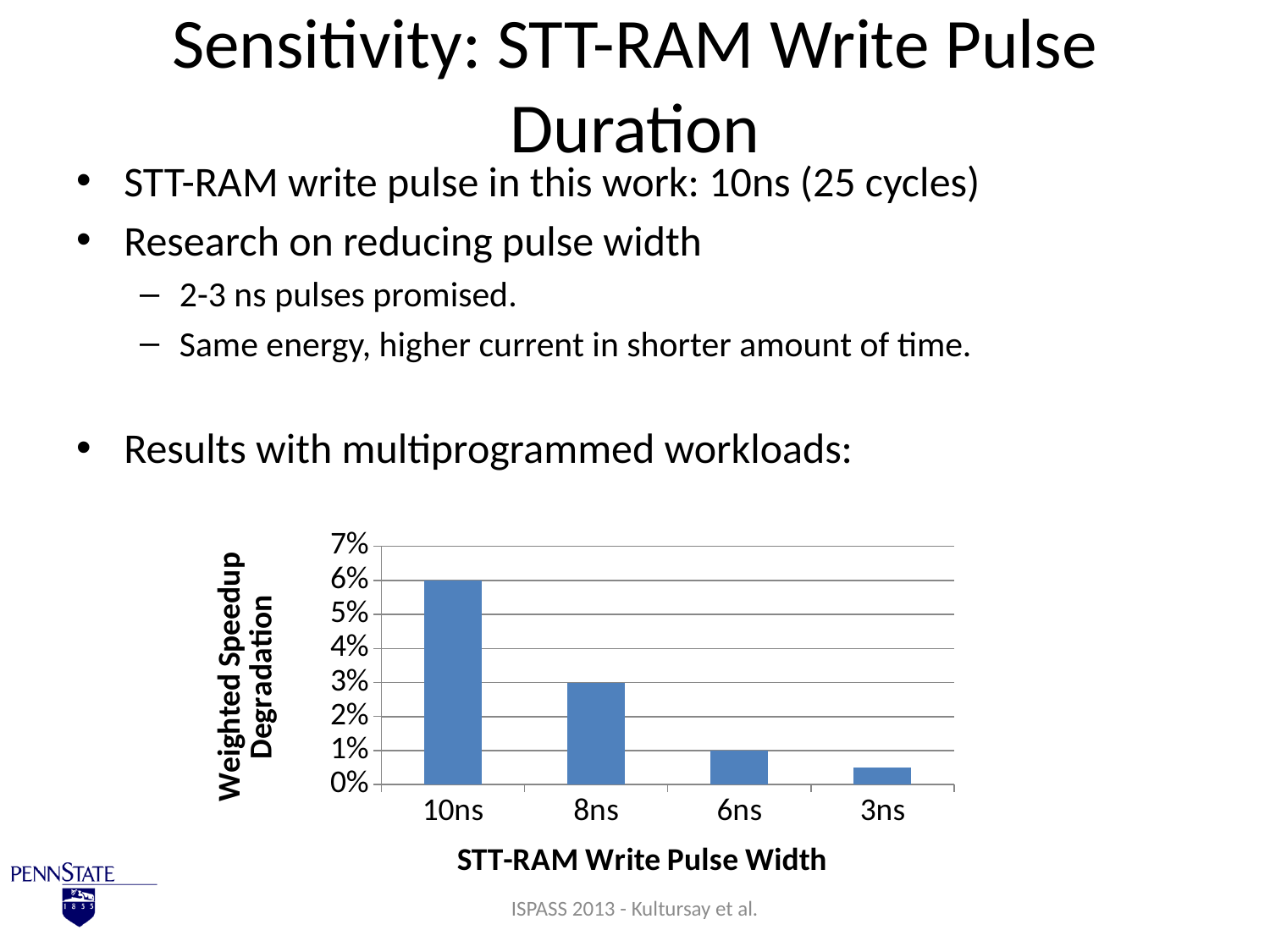
Which write pulse width has the lowest weighted speedup degradation? 3ns How many write pulse width categories are shown on the x axis of the chart? 4 Is the weighted speedup degradation for 10ns greater or less than 5%? greater What is the weighted speedup degradation for an 8ns write pulse width? 3% What kind of chart is shown on the slide? bar chart What is the weighted speedup degradation for a 6ns write pulse width? 1% Which write pulse width has the highest weighted speedup degradation? 10ns What is the difference in weighted speedup degradation between 10ns and 8ns? 3% What is the x-axis title of the chart? STT-RAM Write Pulse Width Is the weighted speedup degradation for 3ns greater or less than 1%? less What is the weighted speedup degradation for a 10ns write pulse width? 6% Which has a larger weighted speedup degradation, 8ns or 6ns? 8ns